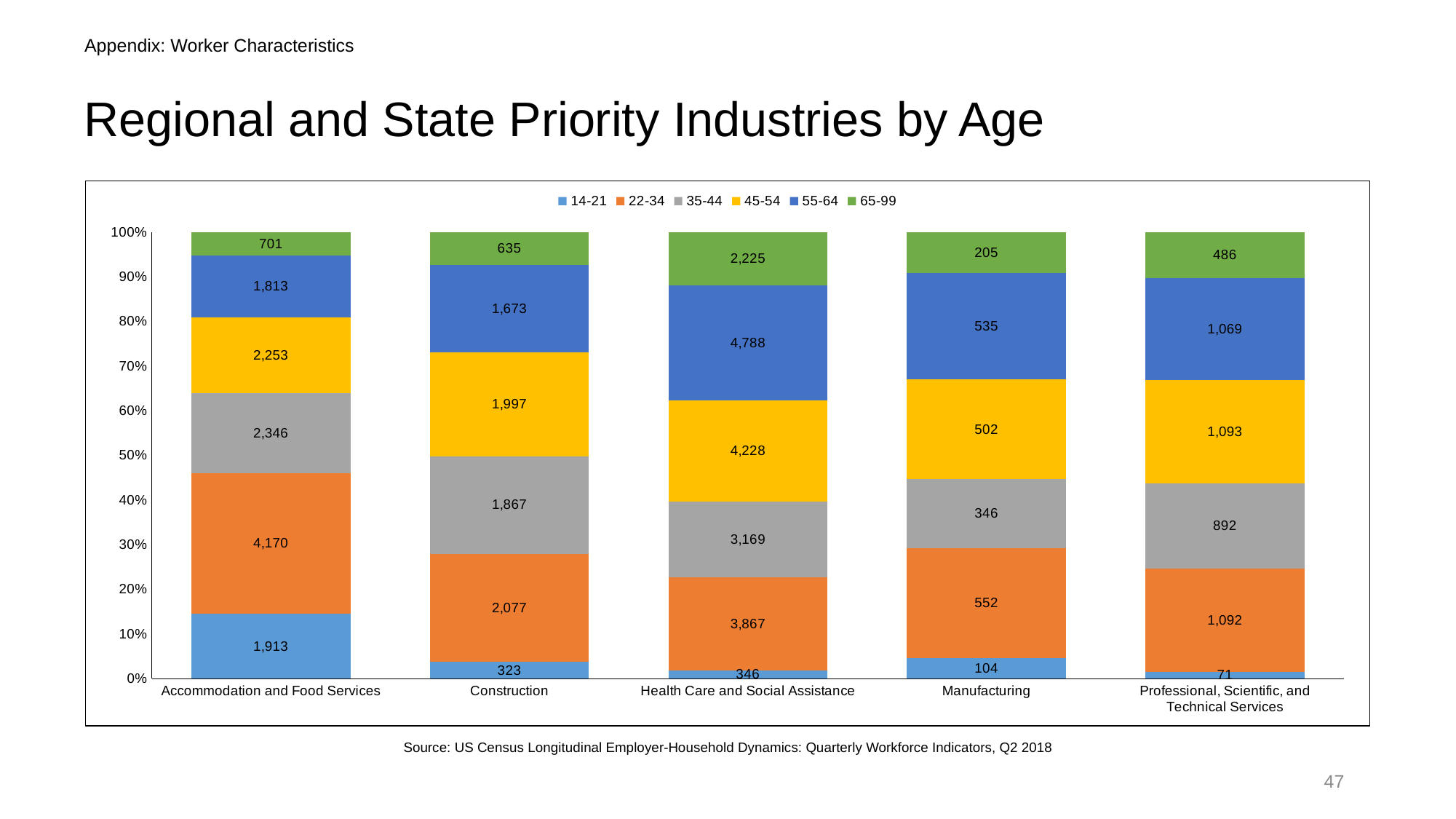
How many industries are shown on the x axis? 5 What is the difference between the 55-64 and 45-54 values in Health Care and Social Assistance? 560 What kind of chart is shown on the slide? Stacked bar chart In Construction, which is larger: the 22-34 value or the 45-54 value? 22-34 How many age groups does the legend list? 6 Is the share of the 14-21 age group in Accommodation and Food Services greater or less than 10%? greater What is the value for the 55-64 age group in Health Care and Social Assistance? 4,788 Which industry has the lowest value for the 14-21 age group? Professional, Scientific, and Technical Services What is the value for the 14-21 age group in Professional, Scientific, and Technical Services? 71 What is the total of all age groups for Manufacturing? 2,244 What is the value for the 22-34 age group in Accommodation and Food Services? 4,170 Which industry has the highest value for the 65-99 age group? Health Care and Social Assistance